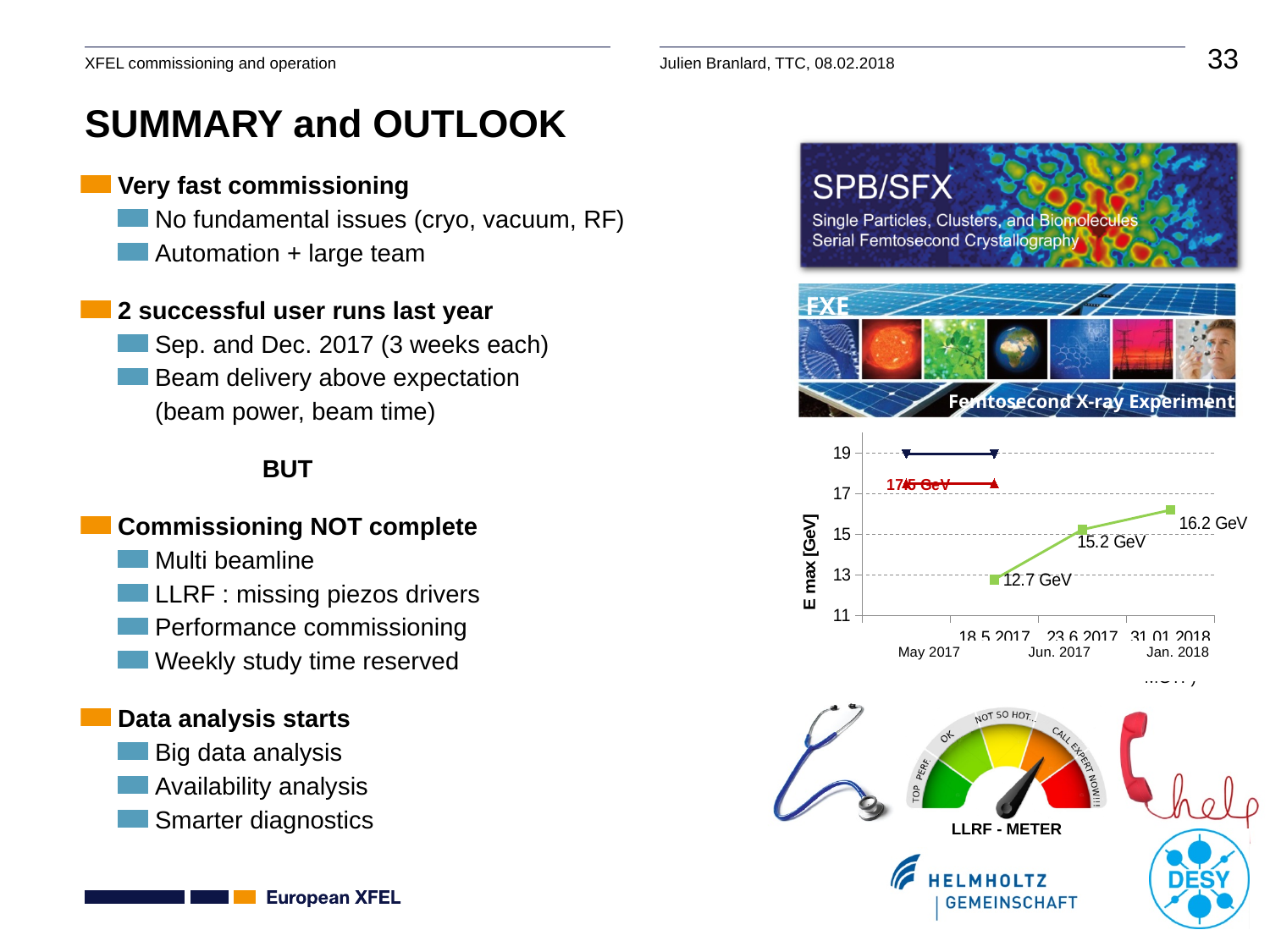
At which date is the plotted E max lowest? May 2017 What is the difference in E max between Jun. 2017 and Jan. 2018? 1.0 GeV What is the E max value plotted for May 2017 (18.5.2017)? 12.7 GeV Which has the larger E max, May 2017 or Jun. 2017? Jun. 2017 What is the label of the vertical axis of the chart? E max [GeV] Is the E max value for May 2017 greater or less than 15? less By how much did E max increase from May 2017 to Jan. 2018? 3.5 GeV Does the plotted E max rise or fall from May 2017 to Jan. 2018? rise What is the E max value plotted for Jan. 2018 (31.01.2018)? 16.2 GeV What is the E max value plotted for Jun. 2017 (23.6.2017)? 15.2 GeV How many dated data points are plotted on the green E max line? 3 At which date is the plotted E max highest? Jan. 2018